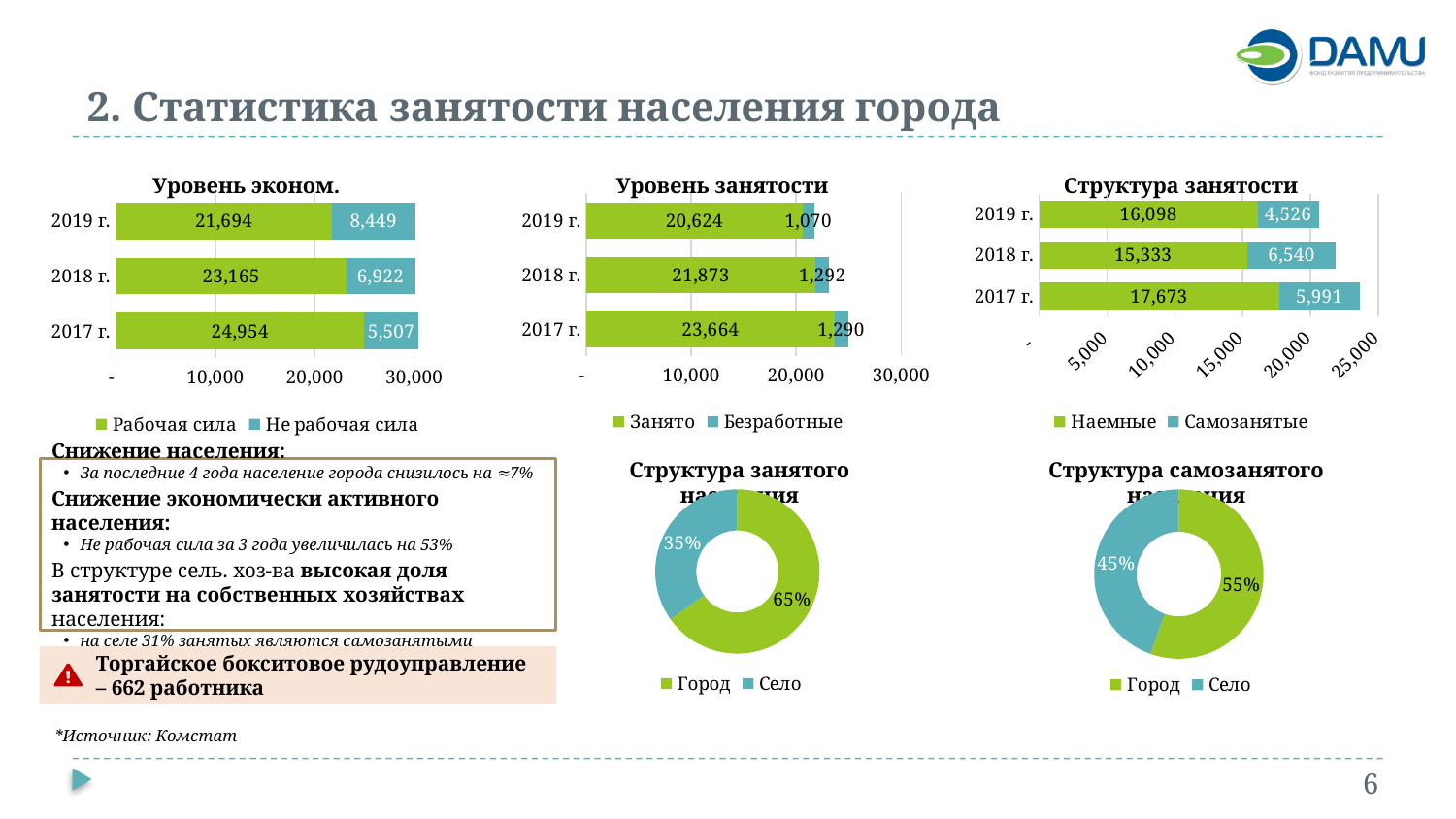
In the 'Структура занятости' chart, how many series does the legend list? 2 In the 'Структура самозанятого населения' chart, which is larger, 'Город' or 'Село'? Город In the 'Уровень эконом.' chart, what is the value of 'Рабочая сила' for 2019 г.? 21,694 In the 'Структура занятости' chart, which year has the lowest value for 'Наемные'? 2018 г. In the 'Уровень занятости' chart, what is the difference between 'Занято' in 2017 г. and 2019 г.? 3,040 In the 'Уровень эконом.' chart, what is the total of the stacked bar for 2017 г.? 30,461 In the 'Структура занятого населения' chart, what share does 'Село' have? 35% In the 'Уровень занятости' chart, what is the value of 'Занято' for 2018 г.? 21,873 In the 'Уровень занятости' chart, does the value of 'Занято' rise or fall from 2017 г. to 2019 г.? fall In the 'Уровень эконом.' chart, which year has the highest value for 'Не рабочая сила'? 2019 г. In the 'Структура занятости' chart, what is the value of 'Самозанятые' for 2018 г.? 6,540 What kind of chart is the 'Структура самозанятого населения' chart? doughnut chart